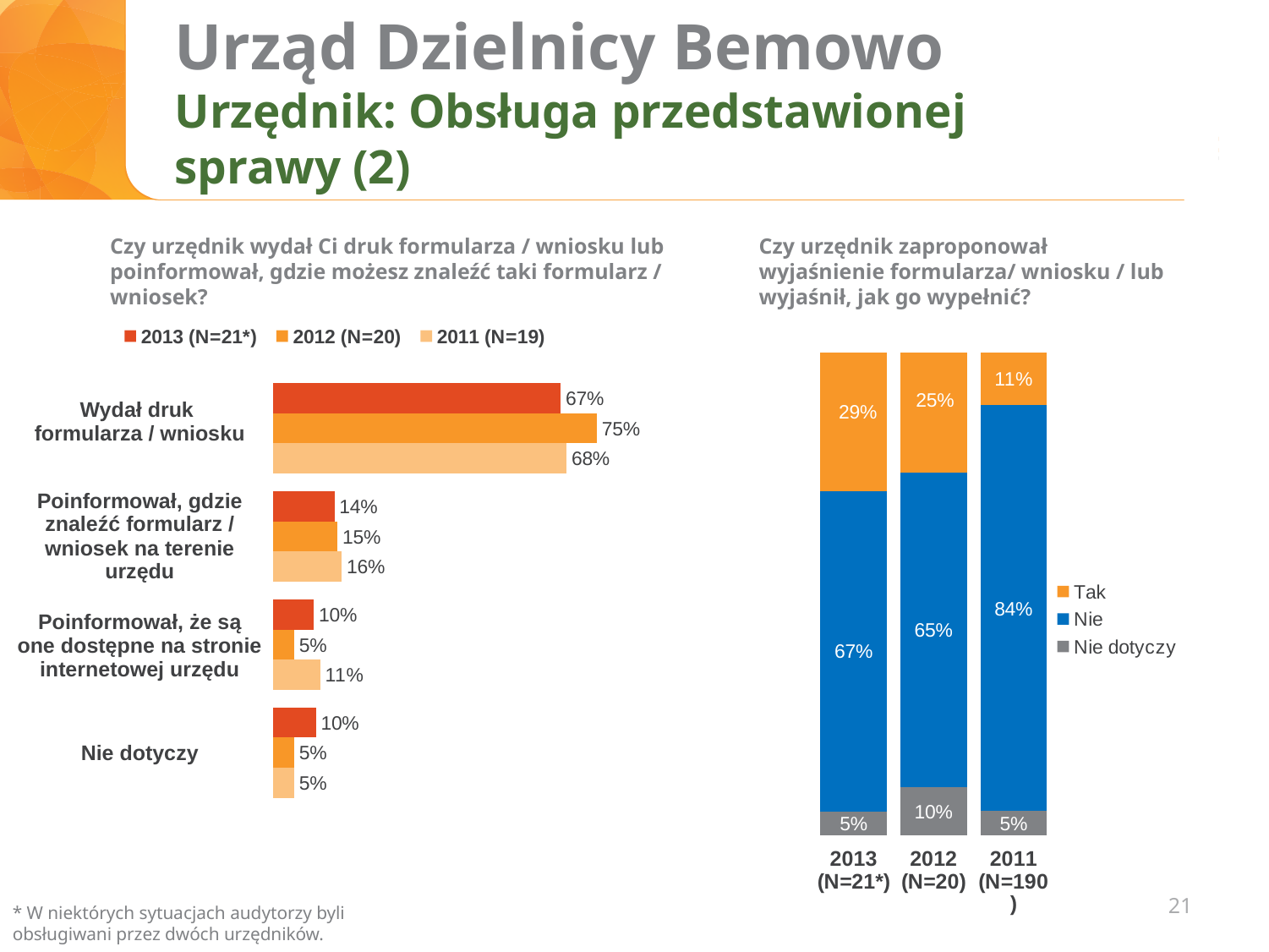
In the right chart, what is the 'Tak' value for 2013 (N=21*)? 29% In the left chart, what is the value for 'Wydał druk formularza / wniosku' in the 2012 (N=20) series? 75% In the left chart, how many categories are shown? 4 In the left chart, what is the value for 'Nie dotyczy' in the 2013 (N=21*) series? 10% In the right chart, what is the difference between the 'Nie dotyczy' values for 2012 and 2013? 5% In the right chart, what is the 'Nie' value for 2011? 84% In the right chart, which year has the lowest 'Tak' value? 2011 In the left chart, what is the difference between the 2012 and 2013 values for 'Wydał druk formularza / wniosku'? 8% In the left chart, which category has the highest value in the 2011 (N=19) series? Wydał druk formularza / wniosku What kind of chart is the chart on the left? Bar chart In the left chart, how many series does the legend list? 3 In the right chart, is the 'Nie' value for 2012 larger or smaller than the 'Nie' value for 2011? Smaller